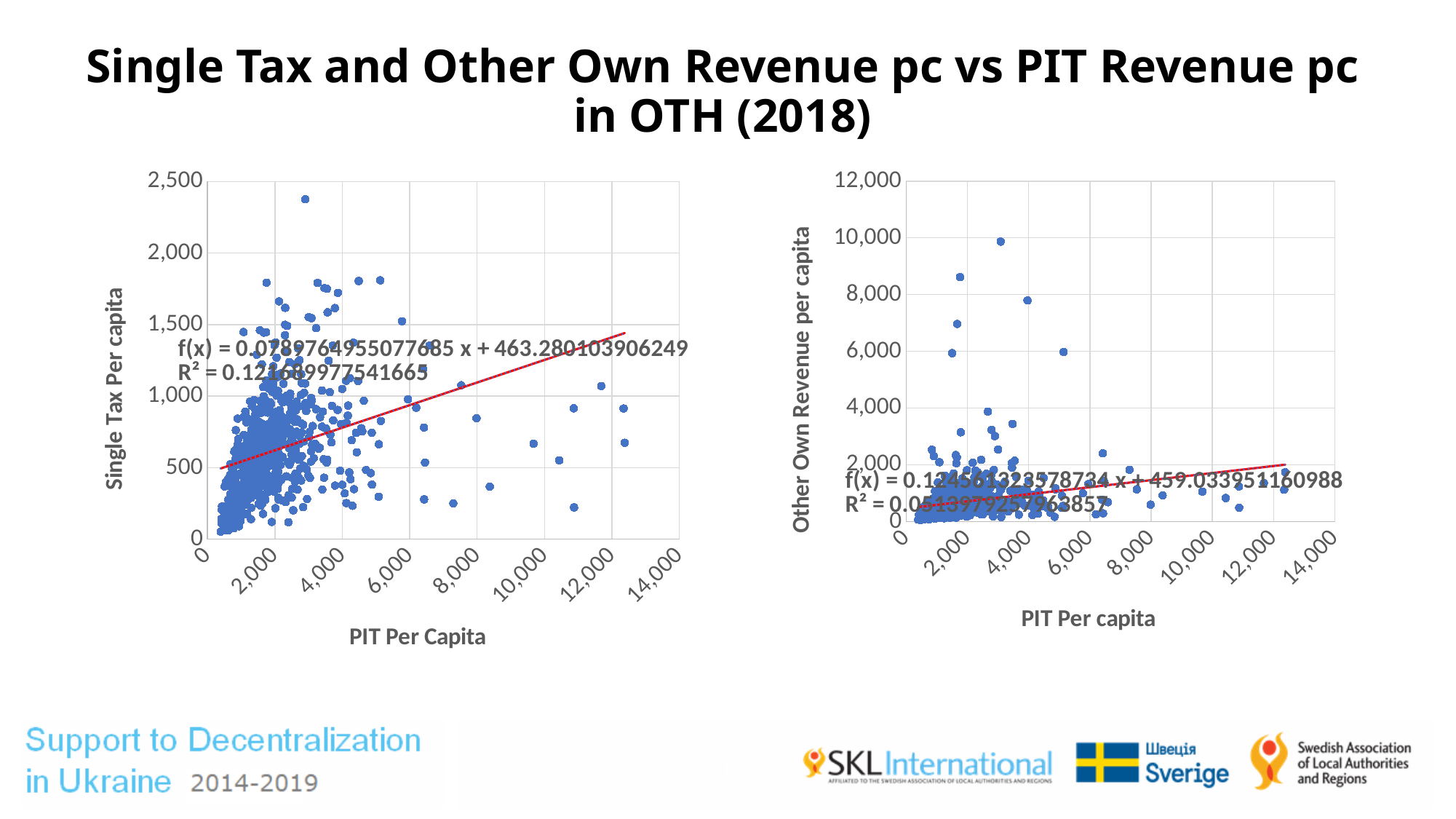
In the right chart, does the red trendline rise or fall as PIT Per capita increases? rise In the right chart, is the PIT Per capita value of the highest point greater or less than 6,000? less In the right chart, what is the intercept (constant term) of the printed trendline equation f(x)? 459.033951160988 What is the y-axis label of the left chart? Single Tax Per capita Which chart has the larger maximum value on its y-axis, the left chart or the right chart? The right chart In the left chart, does the red trendline rise or fall as PIT Per Capita increases? rise What is the y-axis label of the right chart? Other Own Revenue per capita In the left chart, is the highest Single Tax Per capita value greater or less than 2,000? greater In the left chart, what is the intercept (constant term) of the printed trendline equation f(x)? 463.280103906249 What kind of chart is the left chart (Single Tax Per capita vs PIT Per Capita)? Scatter chart In the right chart, is the highest Other Own Revenue per capita value greater or less than 8,000? greater What kind of chart is the right chart (Other Own Revenue per capita vs PIT Per capita)? Scatter chart